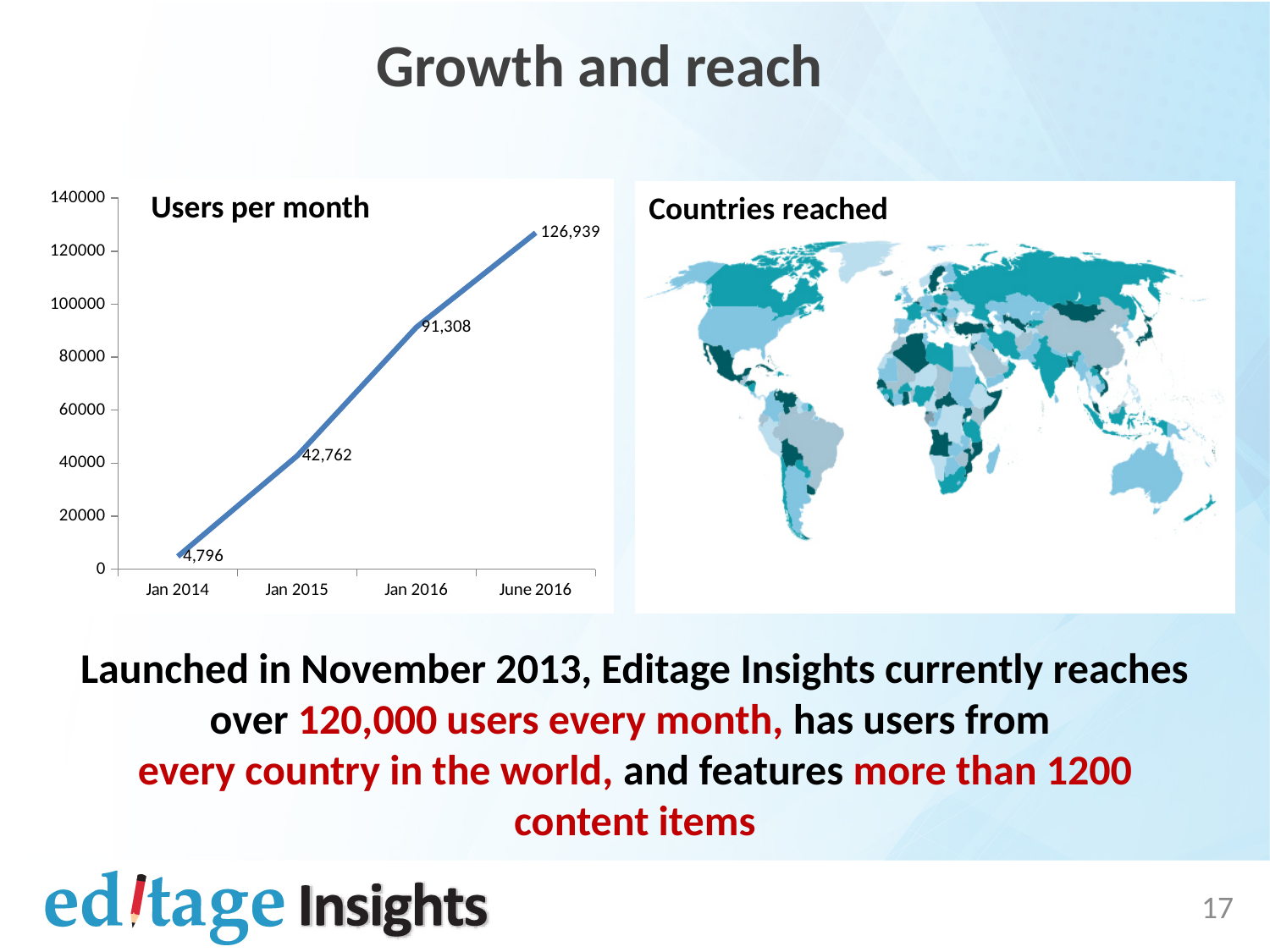
In the 'Users per month' chart, which point on the x axis has the lowest value? Jan 2014 In the 'Users per month' chart, what is the value for Jan 2016? 91,308 In the 'Users per month' chart, which is larger, the value for Jan 2015 or the value for Jan 2016? Jan 2016 In the 'Users per month' chart, which point on the x axis has the highest value? June 2016 What kind of chart is the 'Users per month' chart? line chart In the 'Users per month' chart, what is the difference between the values for Jan 2016 and Jan 2015? 48,546 In the 'Users per month' chart, is the value for Jan 2016 greater or less than 100000? less In the 'Users per month' chart, what is the value for Jan 2015? 42,762 In the 'Users per month' chart, what is the value for Jan 2014? 4,796 In the 'Users per month' chart, what is the value for June 2016? 126,939 In the 'Users per month' chart, what is the difference between the values for June 2016 and Jan 2016? 35,631 How many data points are plotted in the 'Users per month' chart? 4